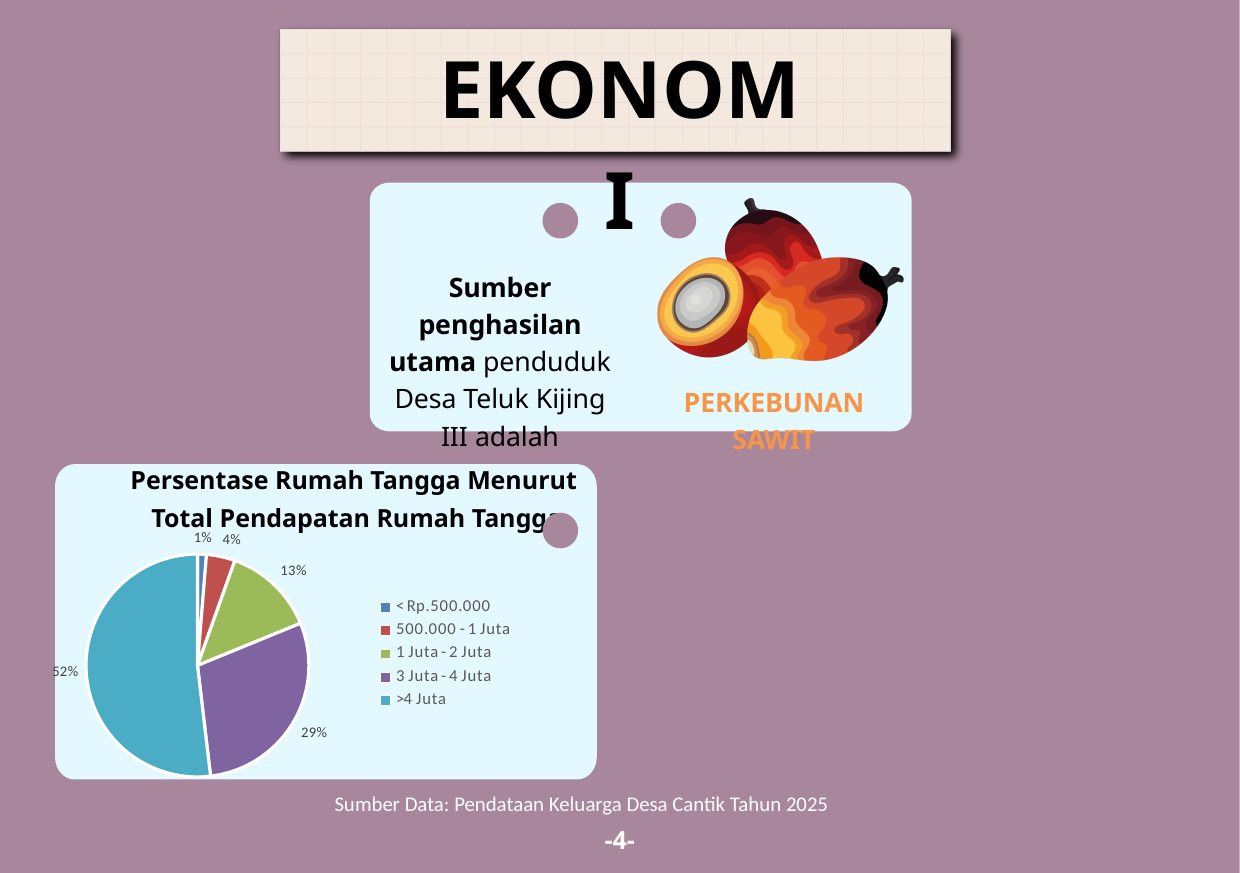
How many categories does the legend of the pie chart list? 5 Which income category has the smallest share of households? < Rp.500.000 Which category has a larger share: 1 Juta - 2 Juta or 500.000 - 1 Juta? 1 Juta - 2 Juta What percentage of households have a total income of < Rp.500.000? 1% What percentage of households fall in the 3 Juta - 4 Juta income category? 29% What percentage of households fall in the 500.000 - 1 Juta income category? 4% Which income category has the largest share of households? >4 Juta What percentage of households have a total income of >4 Juta? 52% What type of chart is shown on the slide? pie chart What is the difference in percentage points between the >4 Juta and 3 Juta - 4 Juta categories? 23 What is the title of the chart? Persentase Rumah Tangga Menurut Total Pendapatan Rumah Tangga What percentage of households fall in the 1 Juta - 2 Juta income category? 13%